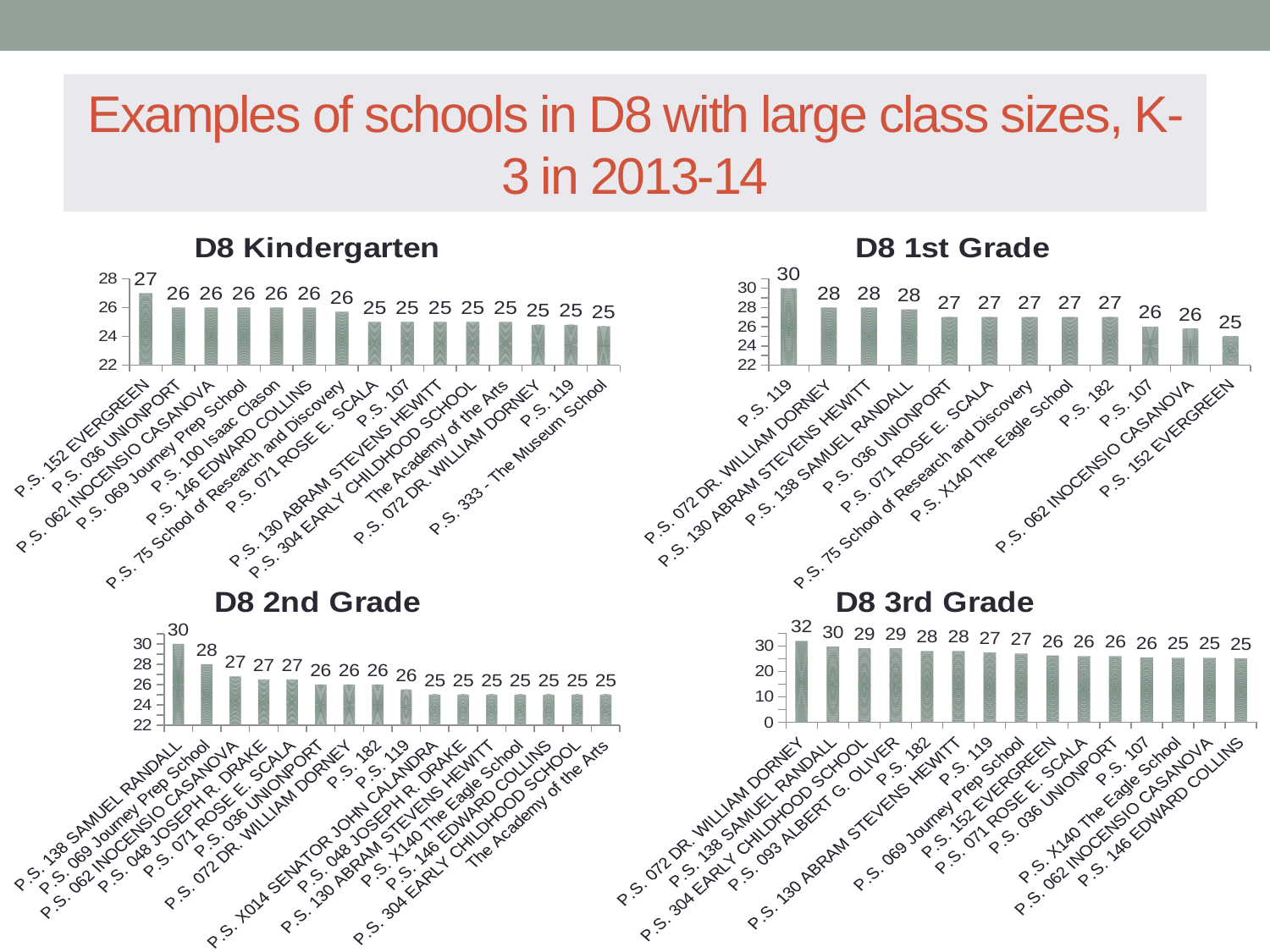
What type of chart is the D8 Kindergarten chart? Bar chart In the D8 1st Grade chart, which school has the highest value? P.S. 119 In the D8 Kindergarten chart, what is the value for P.S. 152 EVERGREEN? 27 In the D8 2nd Grade chart, do the values rise or fall from left to right? Fall In the D8 1st Grade chart, what is the value for P.S. 152 EVERGREEN? 25 In the D8 2nd Grade chart, which is larger, the value for P.S. 069 Journey Prep School or the value for P.S. 036 UNIONPORT? P.S. 069 Journey Prep School How many schools are shown in the D8 1st Grade chart? 12 In the D8 1st Grade chart, what is the difference between the values for P.S. 119 and P.S. 072 DR. WILLIAM DORNEY? 2 In the D8 2nd Grade chart, what is the value for P.S. 138 SAMUEL RANDALL? 30 How many schools are shown in the D8 3rd Grade chart? 15 In the D8 3rd Grade chart, which school has the highest value? P.S. 072 DR. WILLIAM DORNEY In the D8 3rd Grade chart, what is the difference between the values for P.S. 072 DR. WILLIAM DORNEY and P.S. 146 EDWARD COLLINS? 7